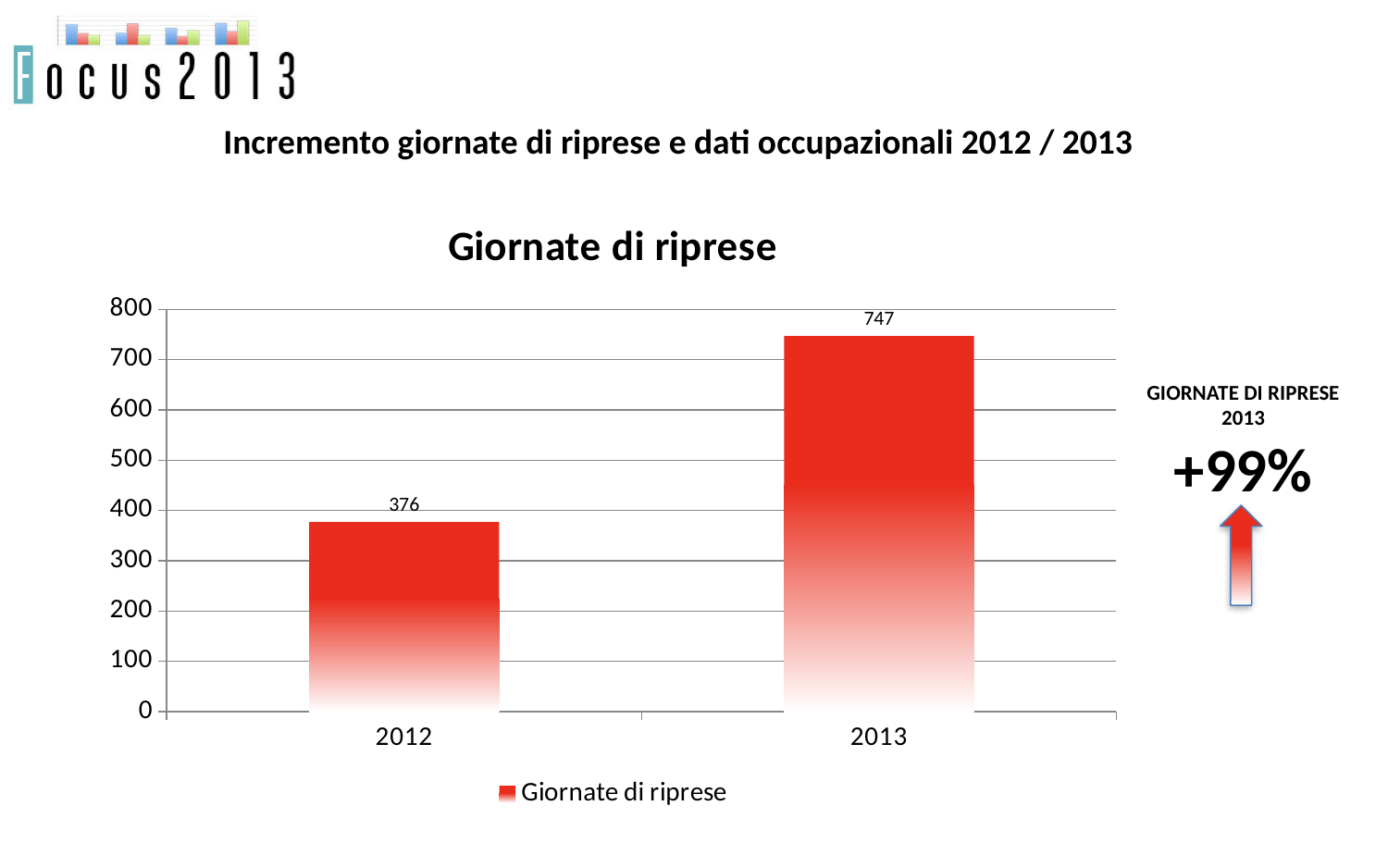
Which year has the lowest value in the Giornate di riprese chart? 2012 How many categories are shown on the x axis of the Giornate di riprese chart? 2 What is the value for 2012 in the Giornate di riprese chart? 376 What is the title of the chart? Giornate di riprese How many series does the legend list? 1 What kind of chart is shown on the slide? bar chart Which year has the highest value in the Giornate di riprese chart? 2013 Which is larger in the Giornate di riprese chart, the value for 2012 or for 2013? 2013 What is the value for 2013 in the Giornate di riprese chart? 747 What is the difference between the 2013 and 2012 values in the Giornate di riprese chart? 371 Is the value for 2013 greater or less than 700? greater Is the value for 2012 greater or less than 400? less